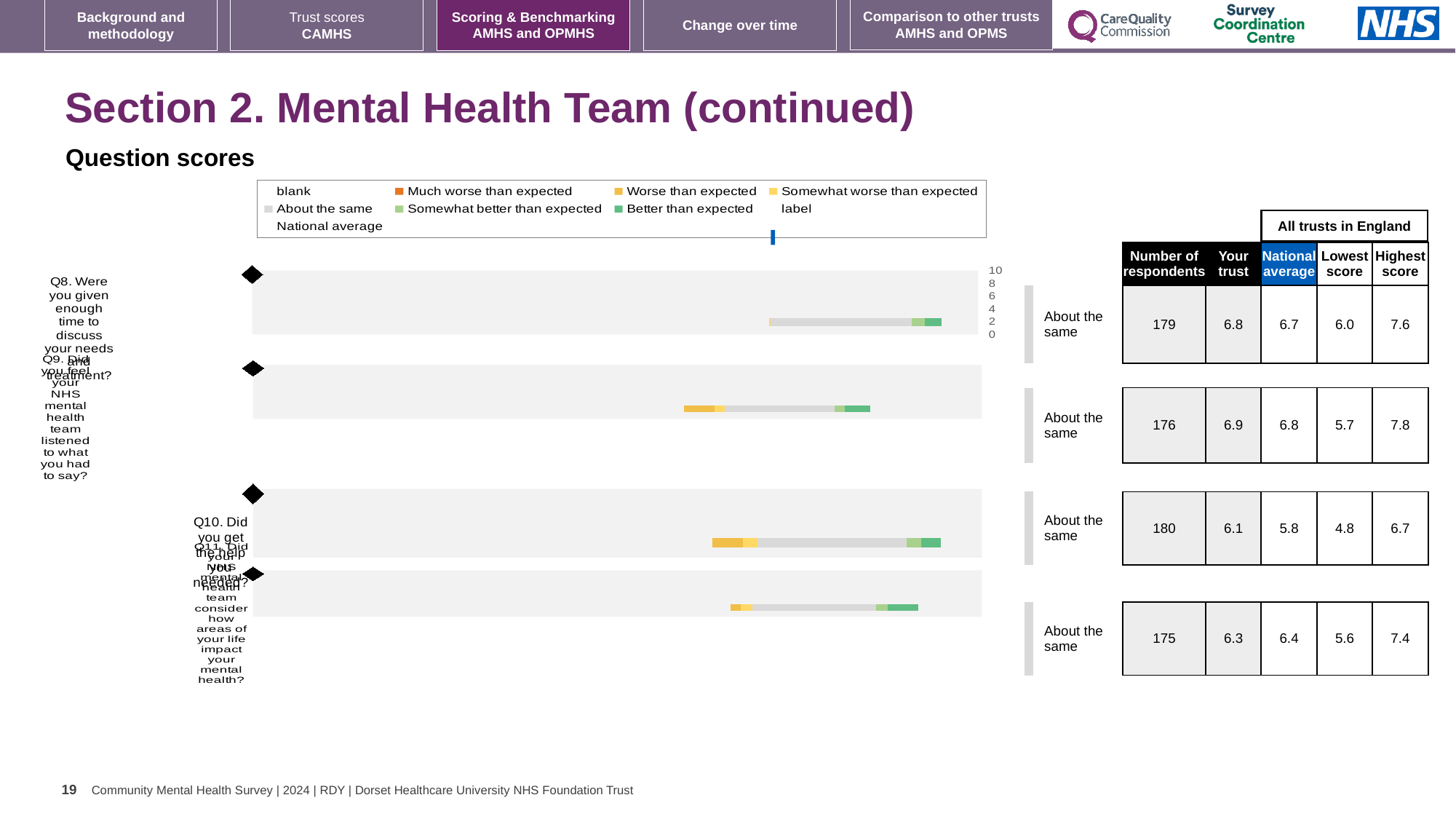
How many entries does the legend above the charts list? 9 How many question charts (Q8 to Q11) are shown on the slide? 4 For Q11, is the 'Your trust' score or the national average score larger in the table? National average In the table beside the Q10 chart, what is the number of respondents? 180 What is the maximum value shown on the score axis of the Q8 chart? 10 Which legend entry is shown in orange? Much worse than expected In the table beside the Q11 chart, what is the highest score among all trusts in England? 7.4 In the table beside the Q8 chart, what is the 'Your trust' score? 6.8 What kind of chart is used to show the question scores for Q8 to Q11? bar chart In the table beside the Q9 chart, what is the national average score? 6.8 Which question has the lowest 'Your trust' score in the table: Q8, Q9, Q10 or Q11? Q10 What is the difference between the 'Your trust' score and the national average for Q10 in the table? 0.3